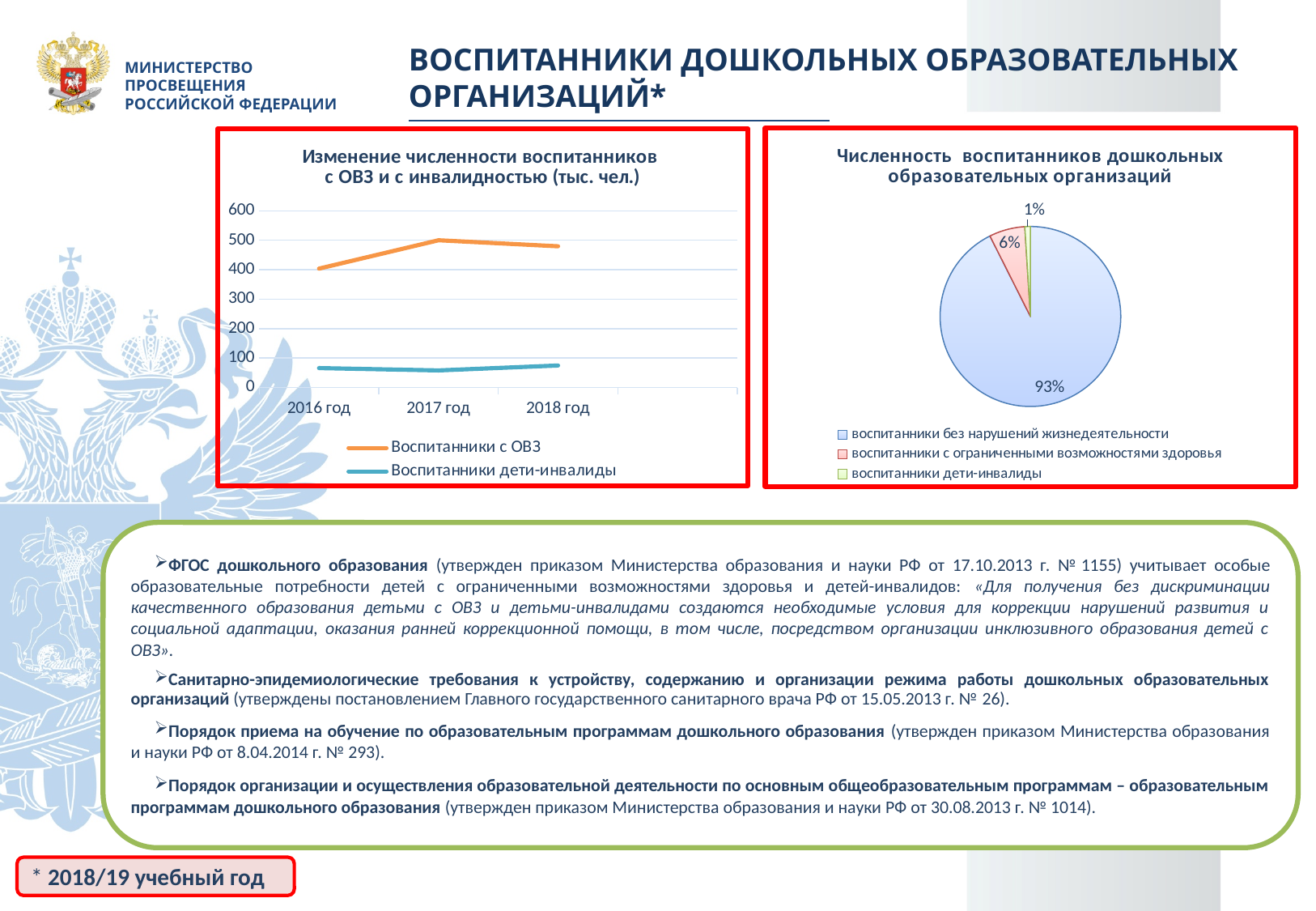
In the left line chart, how many series does the legend list? 2 In the right pie chart, what share is shown for «воспитанники с ограниченными возможностями здоровья»? 6% In the left line chart, is the value for «Воспитанники с ОВЗ» in 2016 год greater or less than 300? greater In the right pie chart, which category has the smallest share? воспитанники дети-инвалиды What kind of chart is the left chart titled «Изменение численности воспитанников с ОВЗ и с инвалидностью (тыс. чел.)»? line chart In the left line chart, how many years are shown on the x axis? 3 In the right pie chart, what share is shown for «воспитанники без нарушений жизнедеятельности»? 93% In the left line chart, is the value for «Воспитанники с ОВЗ» in 2018 год greater or less than 400? greater In the left line chart, is the value for «Воспитанники дети-инвалиды» in 2017 год greater or less than 100? less In the right pie chart, what is the difference between the share of «воспитанники без нарушений жизнедеятельности» and «воспитанники с ограниченными возможностями здоровья»? 87% In the left line chart, which series has higher values in 2017 год: «Воспитанники с ОВЗ» or «Воспитанники дети-инвалиды»? Воспитанники с ОВЗ What kind of chart is the right chart titled «Численность воспитанников дошкольных образовательных организаций»? pie chart